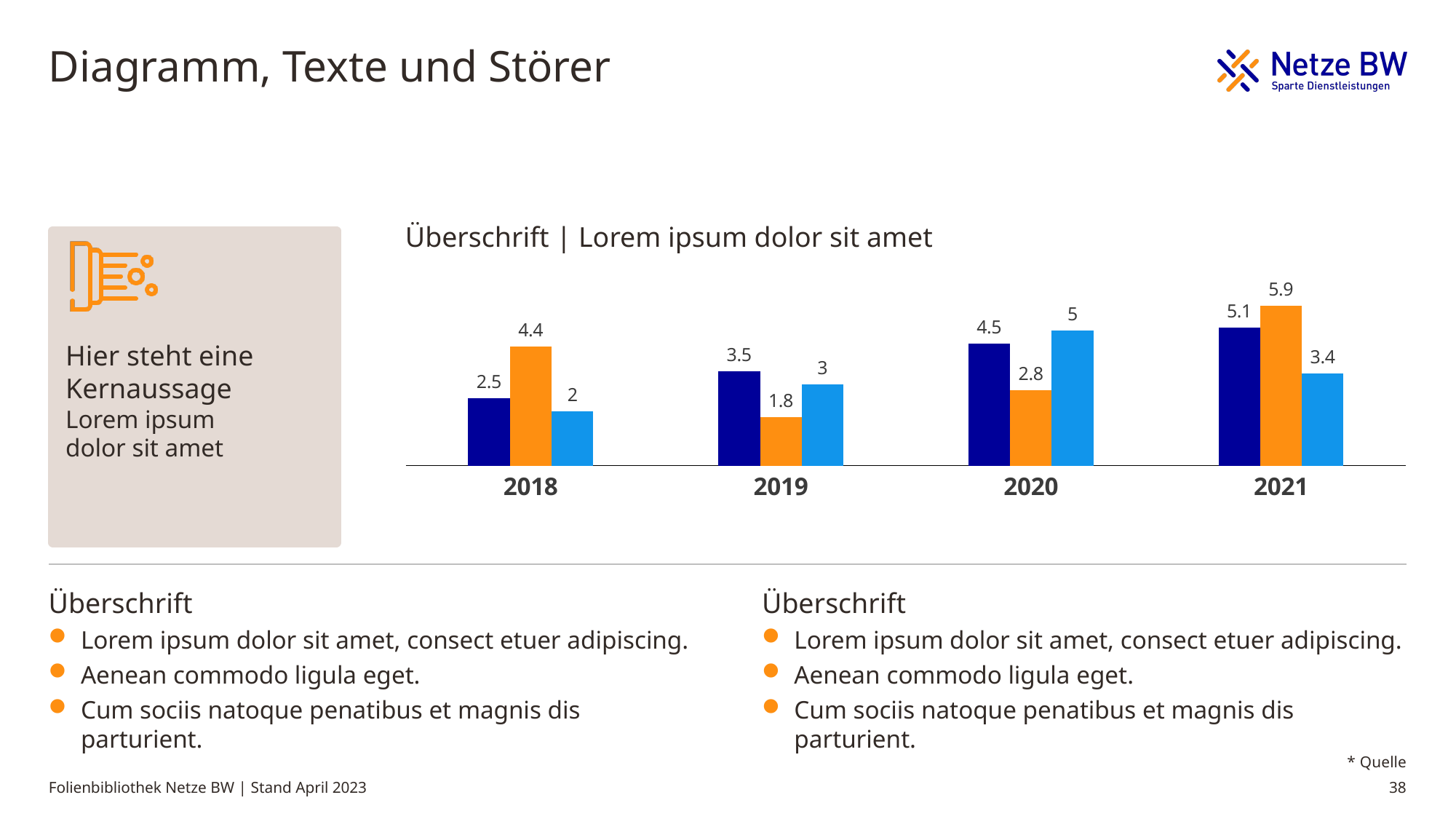
In which year is the orange bar lowest? 2019 Do the dark blue bars rise or fall from 2018 to 2021? Rise What is the difference between the orange bar and the dark blue bar in 2021? 0.8 What type of chart is shown on the slide? Bar chart What is the value of the dark blue bar for 2021? 5.1 What is the title of the chart? Überschrift | Lorem ipsum dolor sit amet What is the value of the light blue bar for 2020? 5 How many years are shown on the x axis? 4 What is the value of the orange bar for 2019? 1.8 What is the value of the orange bar for 2018? 4.4 In which year is the dark blue bar highest? 2021 Which is larger in 2020: the dark blue bar or the light blue bar? The light blue bar